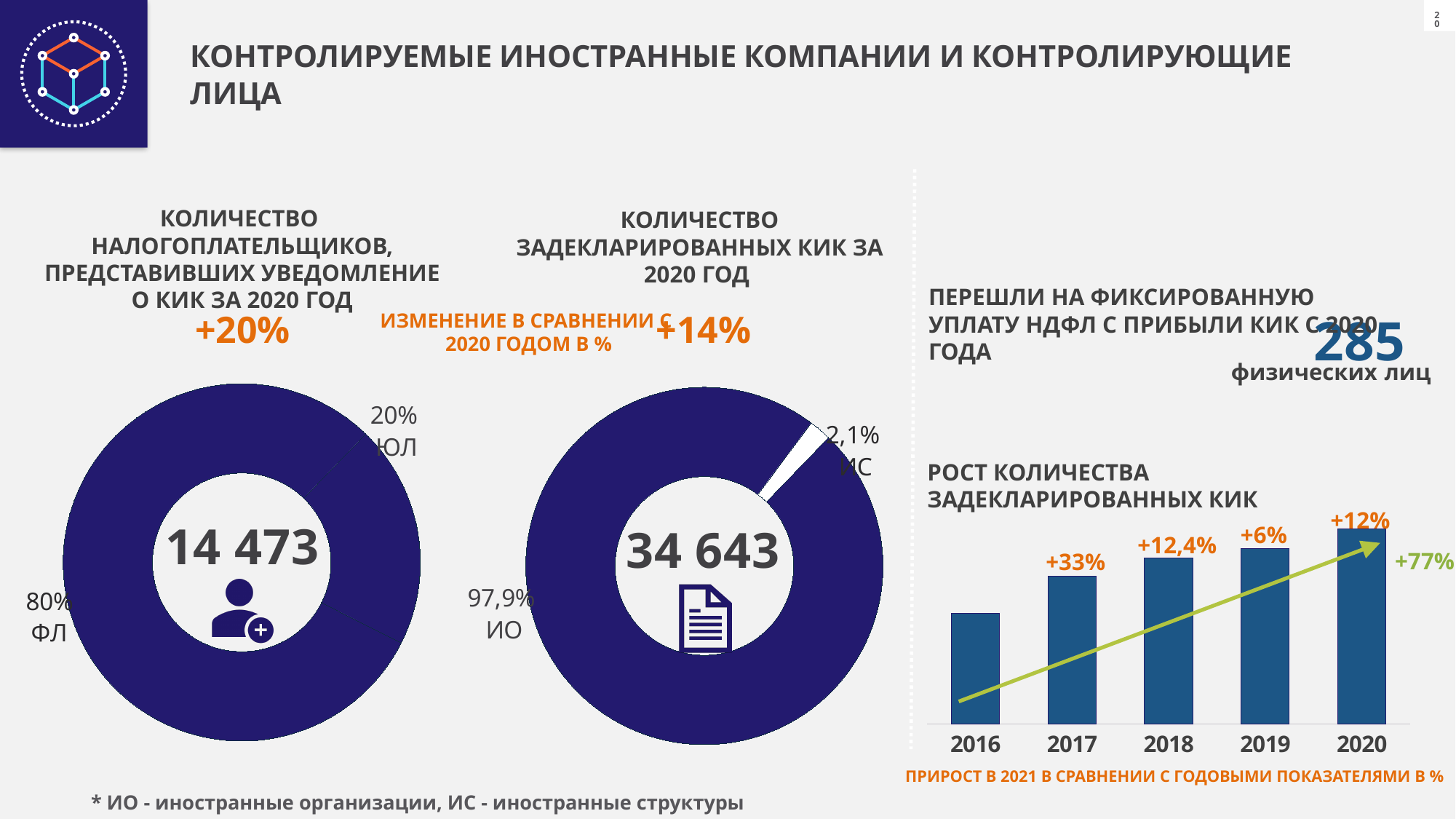
In the middle donut chart, which segment is larger, ИО or ИС? ИО In the middle donut chart, what share is labelled ИС? 2,1% In the left donut chart, what share is labelled ЮЛ? 20% What number is shown in the centre of the middle donut chart? 34 643 In the middle donut chart (КОЛИЧЕСТВО ЗАДЕКЛАРИРОВАННЫХ КИК ЗА 2020 ГОД), what share is labelled ИО? 97,9% In the bar chart РОСТ КОЛИЧЕСТВА ЗАДЕКЛАРИРОВАННЫХ КИК, what label is printed above the 2017 bar? +33% What kind of chart is the chart titled РОСТ КОЛИЧЕСТВА ЗАДЕКЛАРИРОВАННЫХ КИК? bar chart What number is shown in the centre of the left donut chart? 14 473 In the bar chart РОСТ КОЛИЧЕСТВА ЗАДЕКЛАРИРОВАННЫХ КИК, do the bars rise or fall from 2016 to 2020? rise How many years are shown on the x axis of the bar chart РОСТ КОЛИЧЕСТВА ЗАДЕКЛАРИРОВАННЫХ КИК? 5 In the bar chart РОСТ КОЛИЧЕСТВА ЗАДЕКЛАРИРОВАННЫХ КИК, what label is printed above the 2018 bar? +12,4%